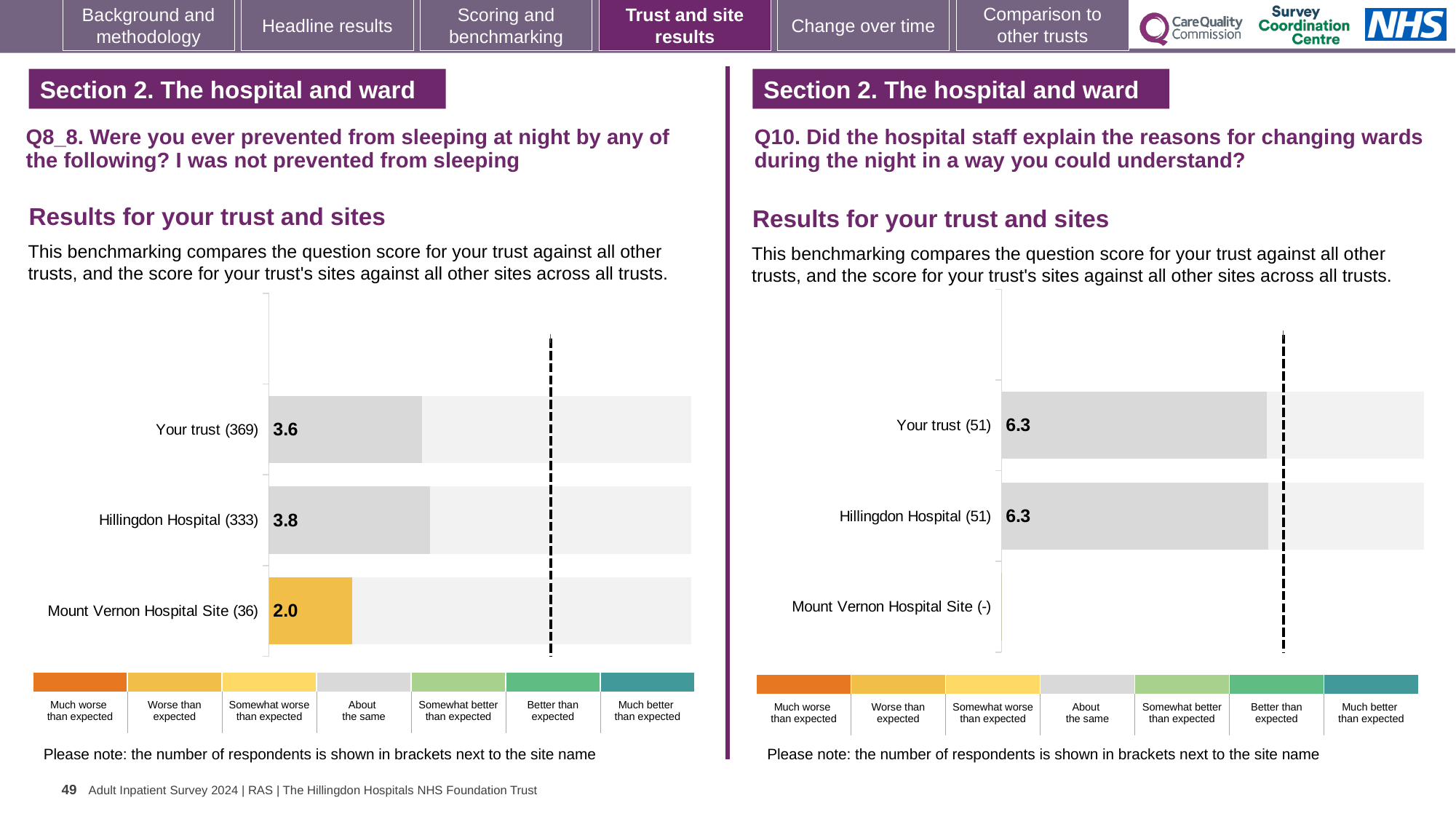
On the Q8_8 chart (left), what is the score for Hillingdon Hospital? 3.8 On the Q8_8 chart (left), what is the score for Mount Vernon Hospital Site? 2.0 On the Q8_8 chart (left), which site or trust has the lowest score? Mount Vernon Hospital Site On the Q8_8 chart (left), what is the score for Your trust? 3.6 On the Q8_8 chart (left), what is the difference between the Hillingdon Hospital score and the Mount Vernon Hospital Site score? 1.8 On the Q10 chart (right), how many rows (sites or trust) are listed? 3 On the Q8_8 chart (left), how many respondents are shown for Mount Vernon Hospital Site? 36 What kind of chart is used on the Q8_8 chart (left)? Bar chart On the Q10 chart (right), how many respondents are shown for Your trust? 51 On the Q10 chart (right), what is the score for Hillingdon Hospital? 6.3 On the Q10 chart (right), what is the score for Your trust? 6.3 On the Q8_8 chart (left), which site or trust has the highest score? Hillingdon Hospital